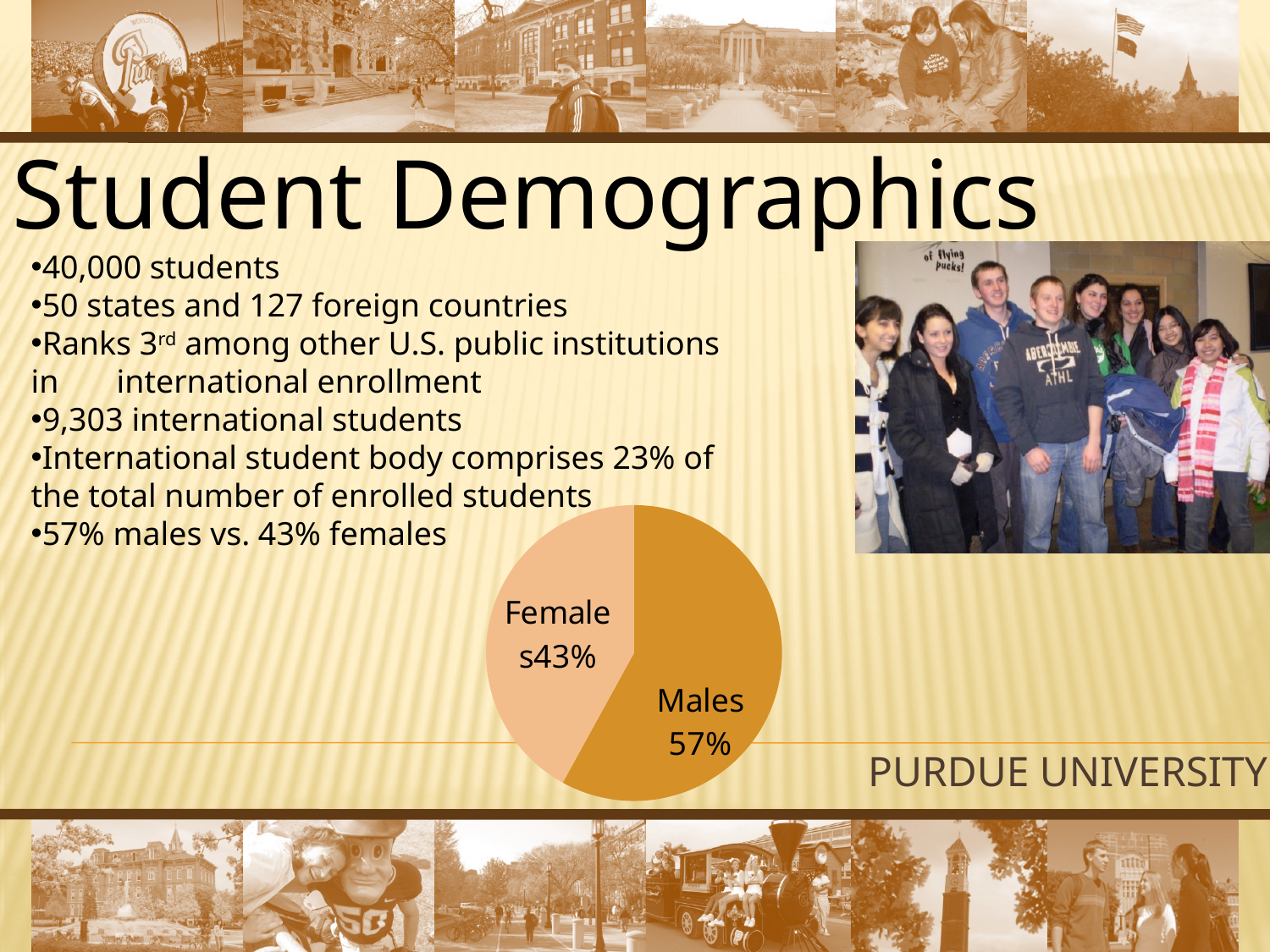
How many slices does the pie chart have? 2 Which slice is larger, Males or Females? Males What share of the pie does the Males slice represent? 57% Which slice of the pie chart is drawn in the darker orange colour? Males Is the Males slice greater or less than 50% of the pie? greater What percentage of the pie chart is Females? 43% What percentage of the pie chart is Males? 57% What is the difference in percentage points between the Males and Females slices? 14 What kind of chart is shown on the slide? pie chart Which slice of the pie chart is the largest? Males Which slice of the pie chart is the smallest? Females